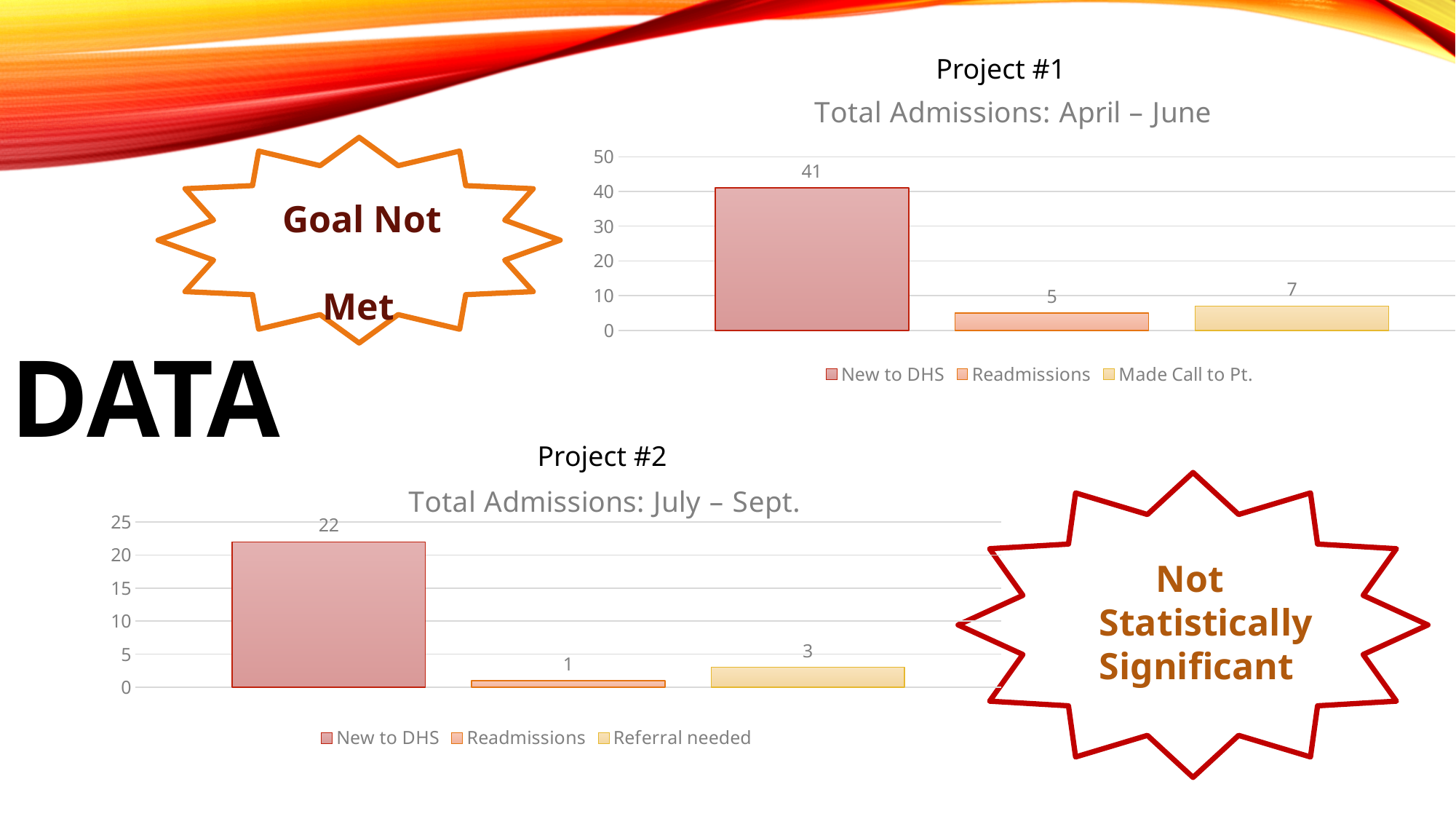
In the 'Total Admissions: July – Sept.' chart, what is the value for New to DHS? 22 In the 'Total Admissions: April – June' chart, what is the difference between New to DHS and Made Call to Pt.? 34 What kind of chart is the 'Total Admissions: July – Sept.' chart? Bar chart In the 'Total Admissions: July – Sept.' chart, which series has the highest value? New to DHS In the 'Total Admissions: April – June' chart, which series has the lowest value? Readmissions In the 'Total Admissions: April – June' chart, how many series does the legend list? 3 In the 'Total Admissions: April – June' chart, what is the value for Readmissions? 5 In the 'Total Admissions: July – Sept.' chart, what is the value for Referral needed? 3 In the 'Total Admissions: July – Sept.' chart, what is the difference between New to DHS and Readmissions? 21 In the 'Total Admissions: April – June' chart, what is the value for Made Call to Pt.? 7 In the 'Total Admissions: April – June' chart, what is the value for New to DHS? 41 In the 'Total Admissions: July – Sept.' chart, which is larger, Readmissions or Referral needed? Referral needed